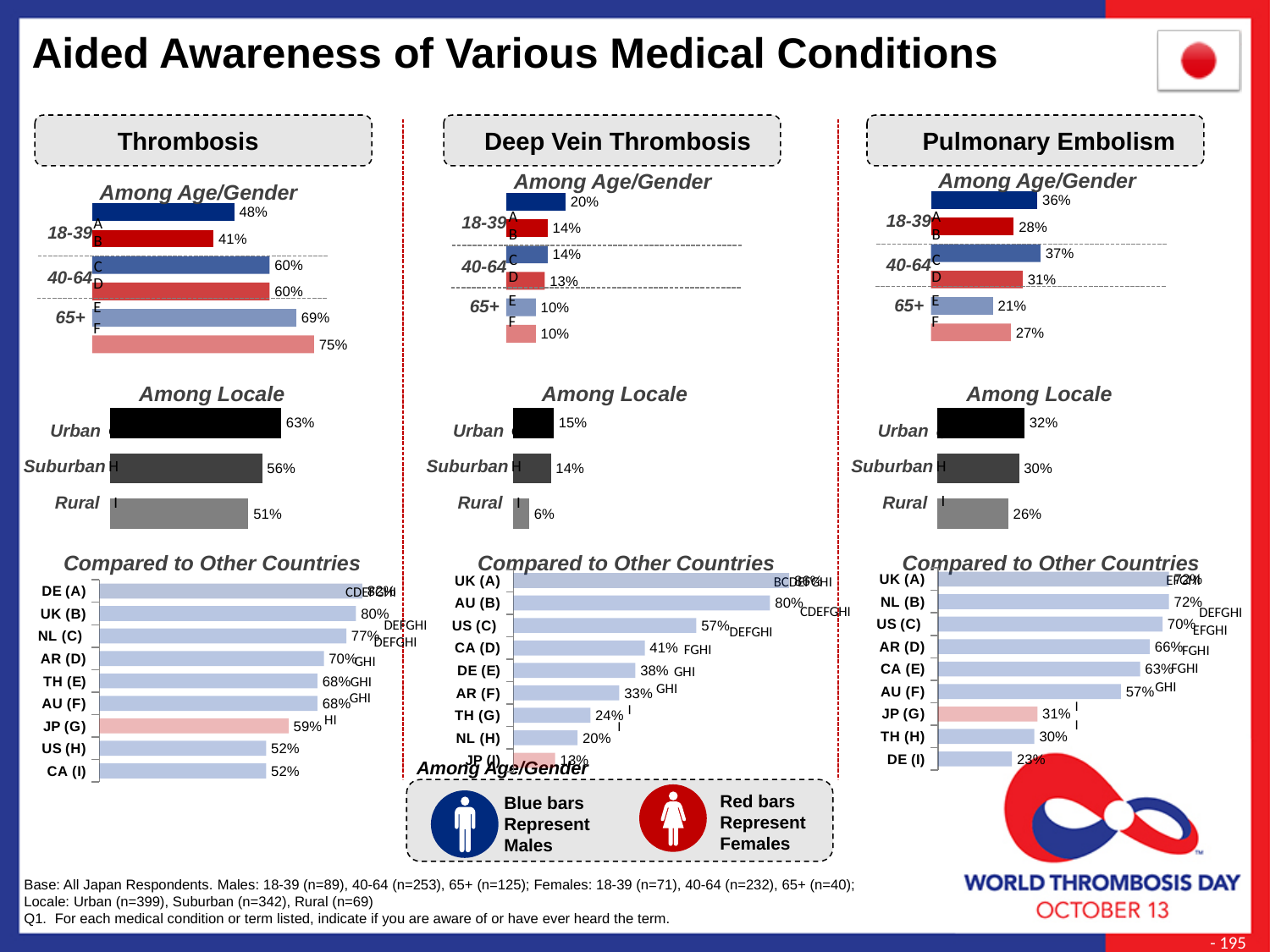
In the Deep Vein Thrombosis 'Compared to Other Countries' chart, what is the value for US (C)? 57% In the Deep Vein Thrombosis 'Among Locale' chart, what is the difference between Urban and Rural? 9% In the Pulmonary Embolism 'Among Locale' chart, what is the value for Suburban? 30% In the Thrombosis 'Among Locale' chart, what is the value for Rural? 51% In the Pulmonary Embolism 'Among Age/Gender' chart, what is the value for males aged 40-64 (bar C)? 37% In the Deep Vein Thrombosis 'Among Age/Gender' chart, what is the value for males aged 18-39 (bar A)? 20% How many countries are listed in the Pulmonary Embolism 'Compared to Other Countries' chart? 9 In the Thrombosis 'Among Locale' chart, which locale has the highest value? Urban In the Pulmonary Embolism 'Among Age/Gender' chart, which is larger: males aged 65+ (E) or females aged 65+ (F)? Females aged 65+ (F) In the Deep Vein Thrombosis 'Among Locale' chart, which locale has the lowest value? Rural In the Thrombosis 'Compared to Other Countries' chart, what is the value for JP (G)? 59% In the Thrombosis 'Among Age/Gender' chart, what is the value for females aged 65+ (bar F)? 75%